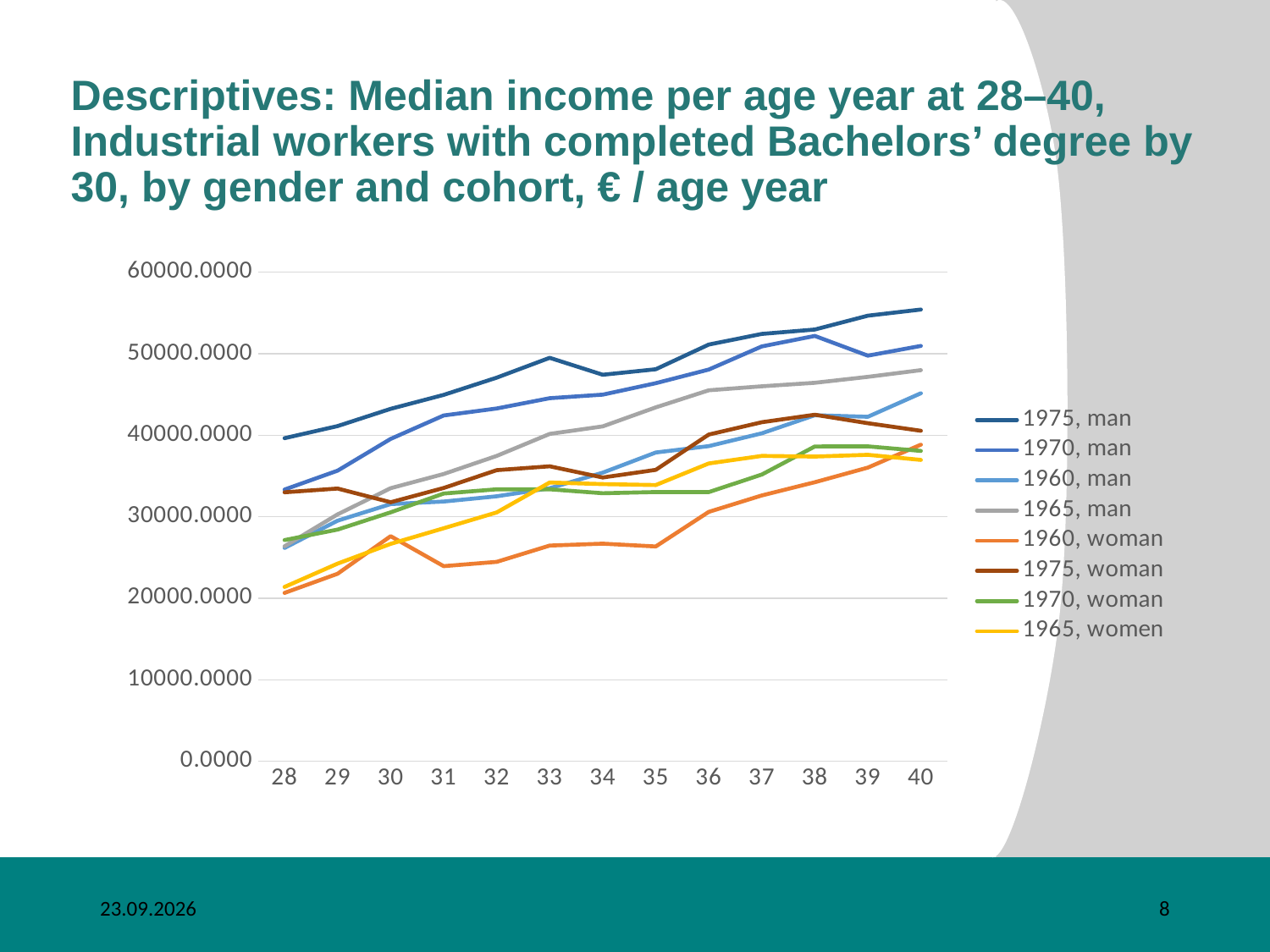
At age 35, which is larger: 1960, woman or 1970, woman? 1970, woman Is the value for 1975, man at age 40 greater or less than 50000? greater Is the value for 1960, woman at age 28 greater or less than 30000? less Which series has the lowest value at age 31? 1960, woman Which series has the highest value at age 28? 1975, man What kind of chart is shown on the slide? line chart What is the highest tick value shown on the y axis? 60000.0000 Which series has the highest value at age 40? 1975, man How many age years are plotted along the x axis? 13 Is the value for 1965, man at age 40 greater or less than 50000? less Does the 1975, man series generally rise or fall from age 28 to age 40? rise How many series does the legend list? 8